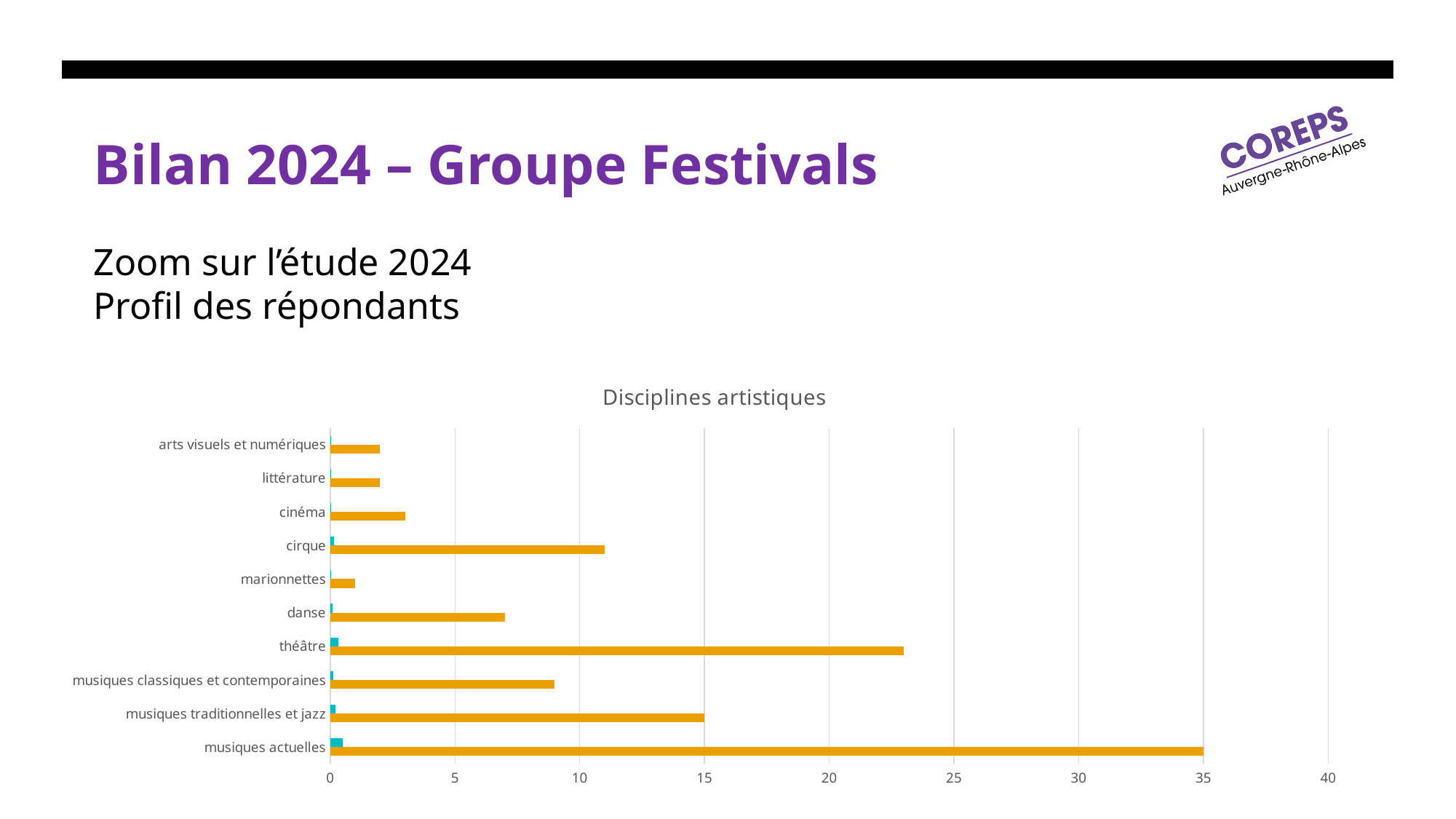
What is the value of the orange bar for musiques actuelles? 35 What is the title of the chart? Disciplines artistiques How many categories are shown on the chart? 10 Is the orange bar for musiques classiques et contemporaines greater or less than 10? less What kind of chart is shown on the slide? bar chart Which category has the highest value on the chart? musiques actuelles Which category has the lowest value for the orange bars? marionnettes What is the value of the orange bar for musiques traditionnelles et jazz? 15 What is the difference between the orange bars for musiques actuelles and musiques traditionnelles et jazz? 20 Which has a larger orange bar, cirque or danse? cirque Is the orange bar for théâtre greater or less than 20? greater Is the orange bar for cinéma greater or less than 5? less